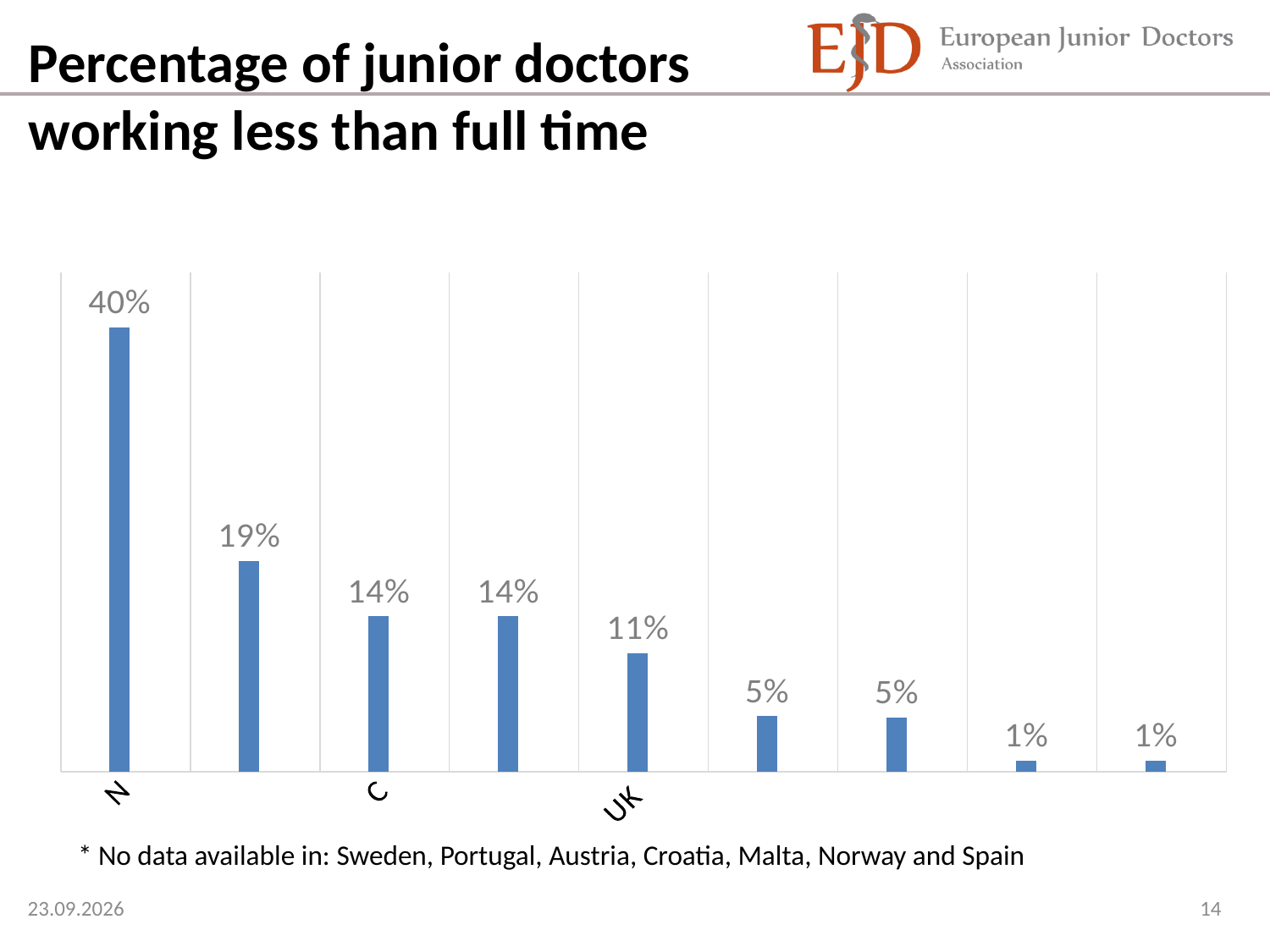
What is the value for UK? 11% What is the value of the second bar from the left? 19% Do the values rise or fall from left to right along the x axis? fall What is the highest value shown in the chart? 40% What is the value of the first (leftmost) bar? 40% What is the title of the slide containing the chart? Percentage of junior doctors working less than full time What is the lowest value shown in the chart? 1% How many bars show a value of 14%? 2 How many bars are plotted in the chart? 9 Which is larger, the value for UK or the value of the second bar from the left? the second bar from the left (19%) What kind of chart is shown on the slide? bar chart What is the difference between the first bar (40%) and the second bar (19%)? 21%